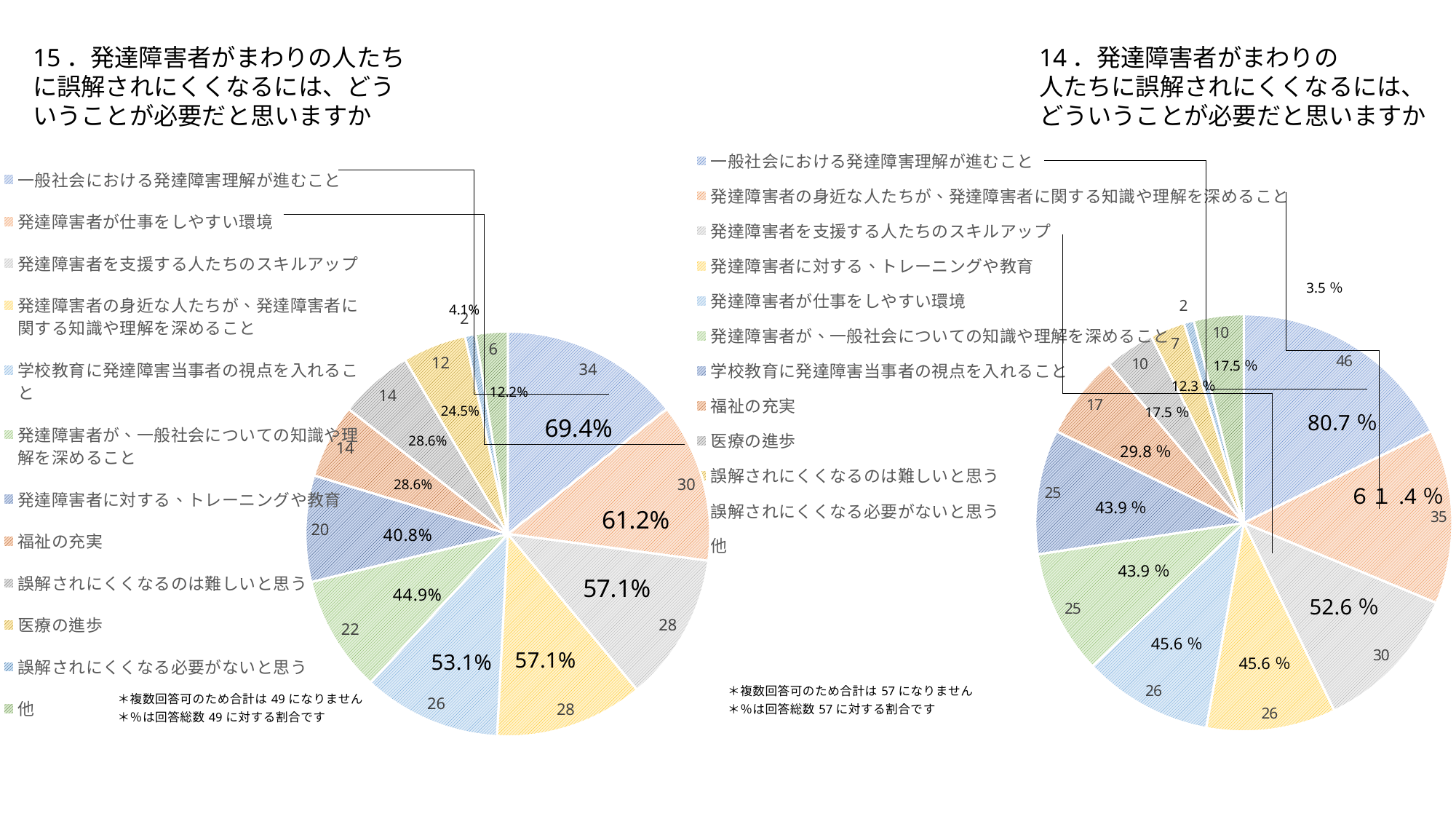
In the left chart (15. 発達障害者がまわりの人たちに誤解されにくくなるには), what percentage is shown for 一般社会における発達障害理解が進むこと? 69.4% In the right chart (14.), what is the difference in count between 一般社会における発達障害理解が進むこと (46) and 発達障害者の身近な人たちが、発達障害者に関する知識や理解を深めること (35)? 11 In the right chart (14.), what count is shown for 発達障害者を支援する人たちのスキルアップ? 30 In the right chart (14.), what is the smallest percentage shown? 3.5 % In the right chart (14.), which is larger: the count for 福祉の充実 or the count for 発達障害者を支援する人たちのスキルアップ? 発達障害者を支援する人たちのスキルアップ According to the note under the right chart (14.), what is the total number of respondents? 57 In the right chart (14. 発達障害者がまわりの人たちに誤解されにくくなるには), what percentage is shown for 一般社会における発達障害理解が進むこと? 80.7 % In the left chart (15.), what is the smallest percentage shown? 4.1% What type of charts are shown on the slide? Pie charts In the left chart (15.), which category has the largest slice? 一般社会における発達障害理解が進むこと In the left chart (15.), how many categories does the legend list? 12 In the left chart (15.), what count is shown for 発達障害者が仕事をしやすい環境? 30